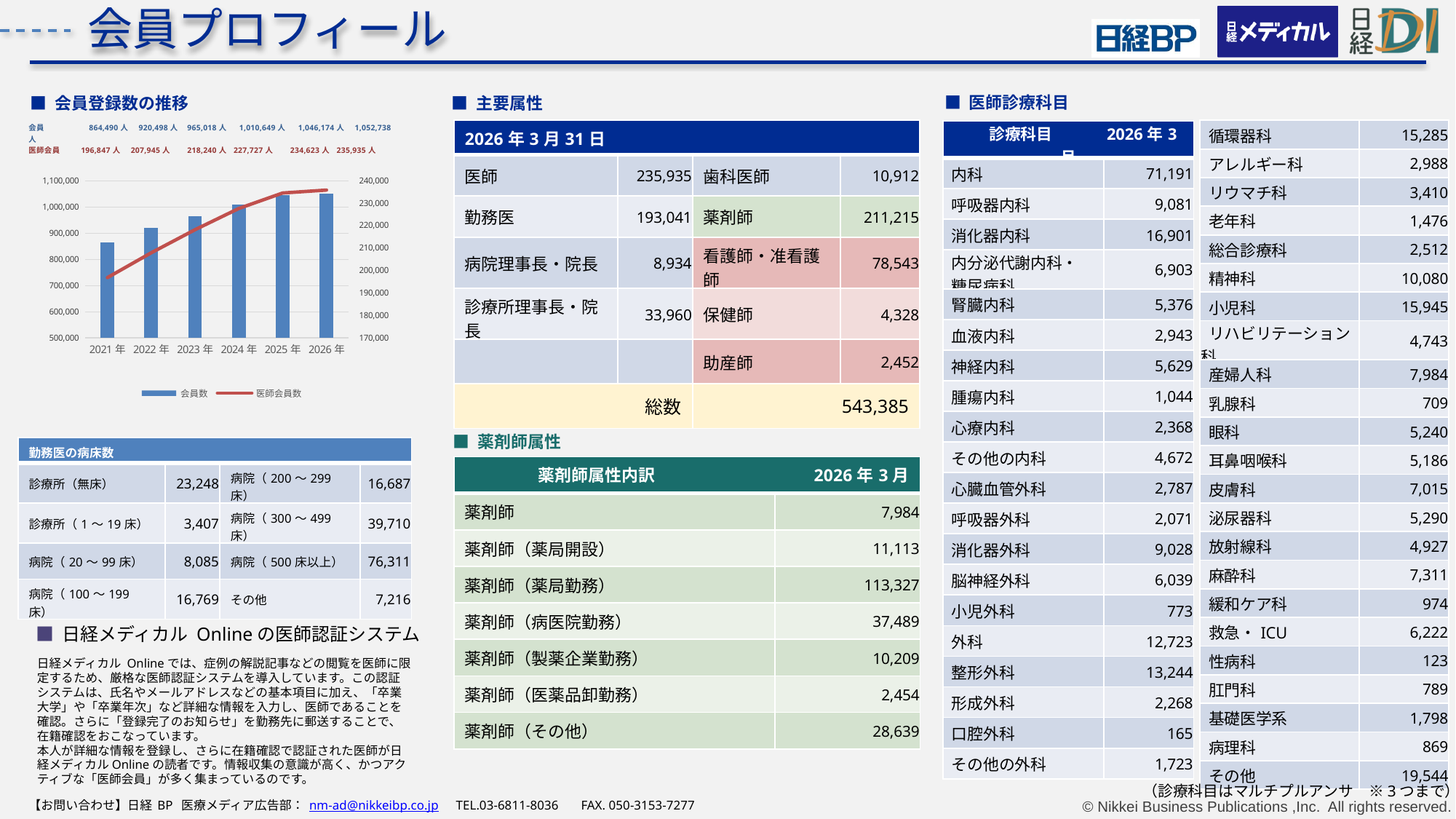
In the 会員登録数の推移 chart, what is the 会員数 value for 2024年? 1,010,649人 In the 会員登録数の推移 chart, what is the 医師会員 value for 2026年? 235,935人 In the 会員登録数の推移 chart, is the 会員数 bar for 2022年 greater or less than 900,000? greater What kind of chart is the 会員登録数の推移 chart? Combined bar and line chart How many years are shown on the x axis of the 会員登録数の推移 chart? 6 In the 会員登録数の推移 chart, which year has the lowest 医師会員 value? 2021年 In the 会員登録数の推移 chart, do the 医師会員 values rise or fall from 2021年 to 2026年? rise In the 会員登録数の推移 chart, what is the difference in 会員数 between 2026年 and 2021年? 188,248人 How many series does the legend of the 会員登録数の推移 chart list? 2 In the 会員登録数の推移 chart, is the 会員数 for 2023年 larger or smaller than the 会員数 for 2022年? larger In the 会員登録数の推移 chart, what is the 会員数 value for 2021年? 864,490人 In the 会員登録数の推移 chart, which year has the highest 会員数? 2026年